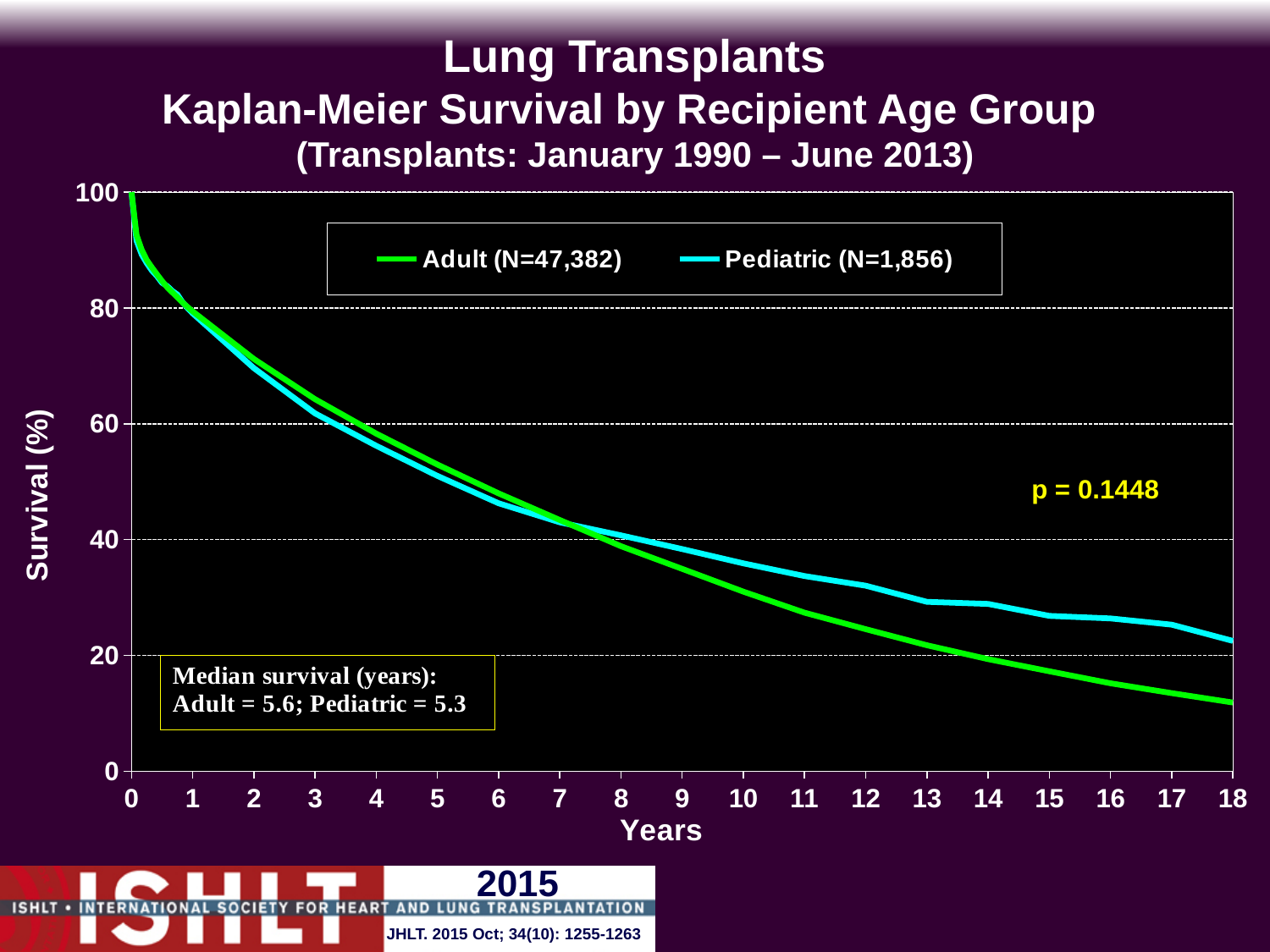
Is the Pediatric survival at 13 years greater or less than 40? less What is the median survival in years for pediatric recipients? 5.3 What is the number of adult recipients (N) shown in the legend? 47,382 Is the Adult survival at 18 years greater or less than 20? less What kind of chart is shown on the slide? line chart At 15 years, which group has the higher survival, Adult or Pediatric? Pediatric Do the survival curves rise or fall as years increase? fall What is the median survival in years for adult recipients? 5.6 What p-value is shown on the chart? p = 0.1448 What is the number of pediatric recipients (N) shown in the legend? 1,856 How many series does the legend list? 2 What is the label of the x axis? Years